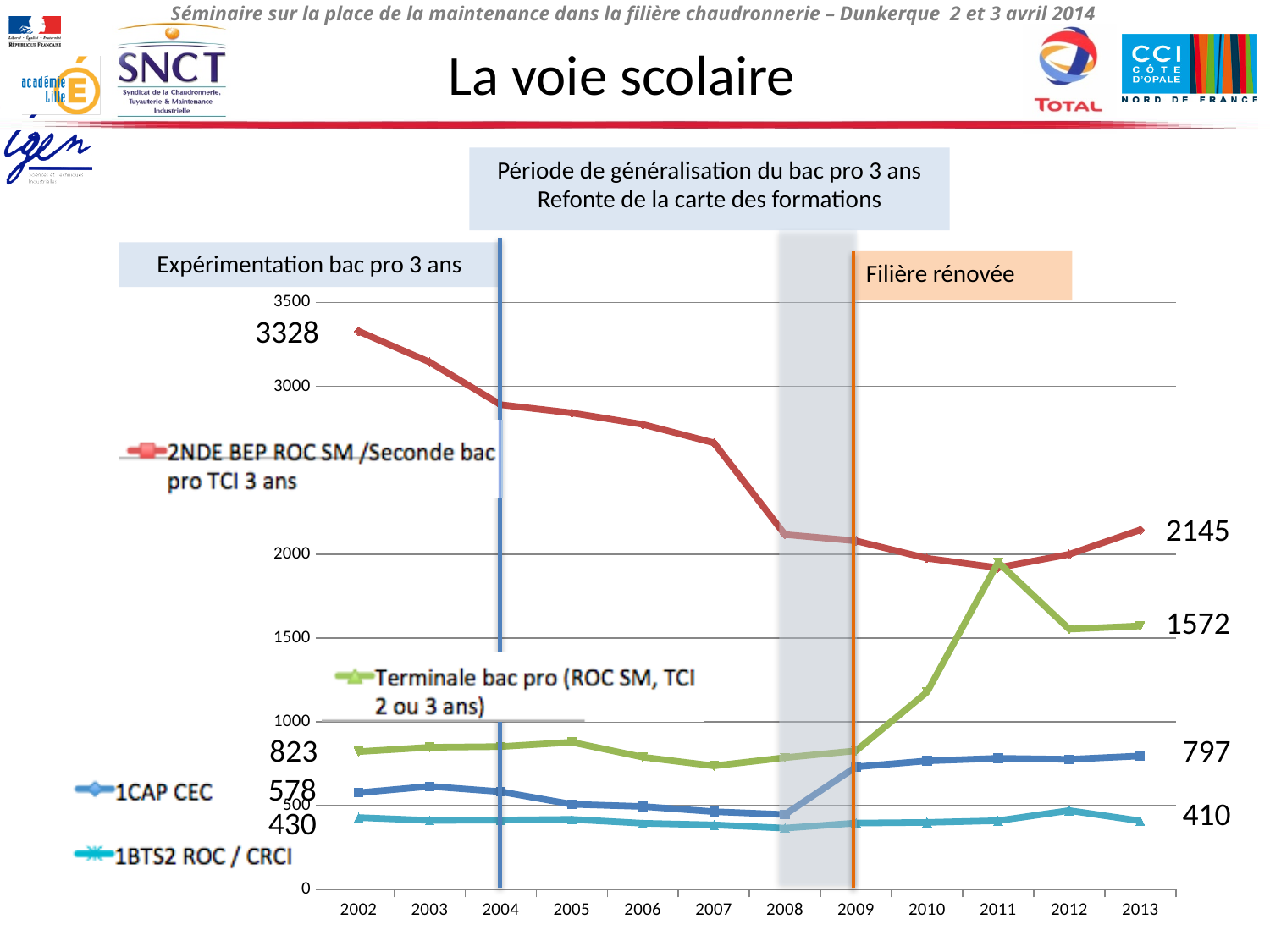
What type of chart is shown on the slide? line chart By how much did the 2NDE BEP ROC SM /Seconde bac pro TCI 3 ans series fall between 2002 and 2013? 1183 How many series does the chart's legend list? 4 What is the value of the 1CAP CEC series in 2002? 578 How many years are shown on the x axis of the chart? 12 What is the value of the 2NDE BEP ROC SM /Seconde bac pro TCI 3 ans series in 2013? 2145 What is the value of the 1BTS2 ROC / CRCI series in 2013? 410 Which series has the highest value in 2002? 2NDE BEP ROC SM /Seconde bac pro TCI 3 ans What is the value of the 2NDE BEP ROC SM /Seconde bac pro TCI 3 ans series in 2002? 3328 What is the value of the Terminale bac pro (ROC SM, TCI 2 ou 3 ans) series in 2013? 1572 Does the 2NDE BEP ROC SM /Seconde bac pro TCI 3 ans series rise or fall between 2002 and 2008? fall Is the value of the Terminale bac pro (ROC SM, TCI 2 ou 3 ans) series in 2010 greater or less than 1000? greater